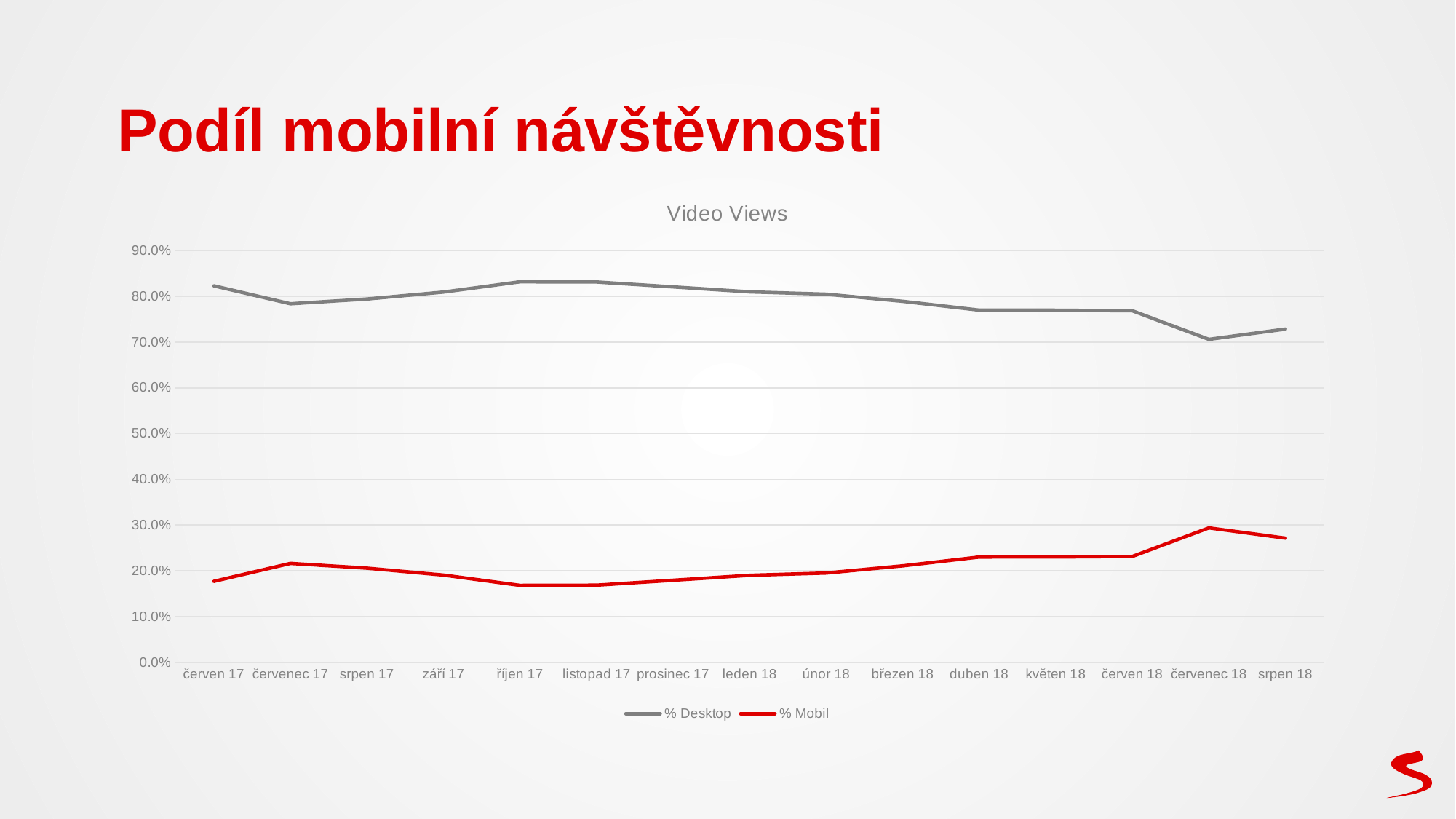
Is the value for % Desktop in červen 17 greater or less than 80.0%? greater What is the title of the chart? Video Views Which series is drawn in red? % Mobil How many months are plotted along the x axis? 15 In which month does % Mobil reach its highest value? červenec 18 Which series has the larger value in srpen 18, % Desktop or % Mobil? % Desktop Is the value for % Desktop in duben 18 greater or less than 80.0%? less How many series does the legend list? 2 In which month does % Desktop reach its lowest value? červenec 18 What kind of chart is shown on the slide? line chart Does the % Desktop line rise or fall from listopad 17 to červenec 18? fall Is the value for % Mobil in duben 18 greater or less than 20.0%? greater